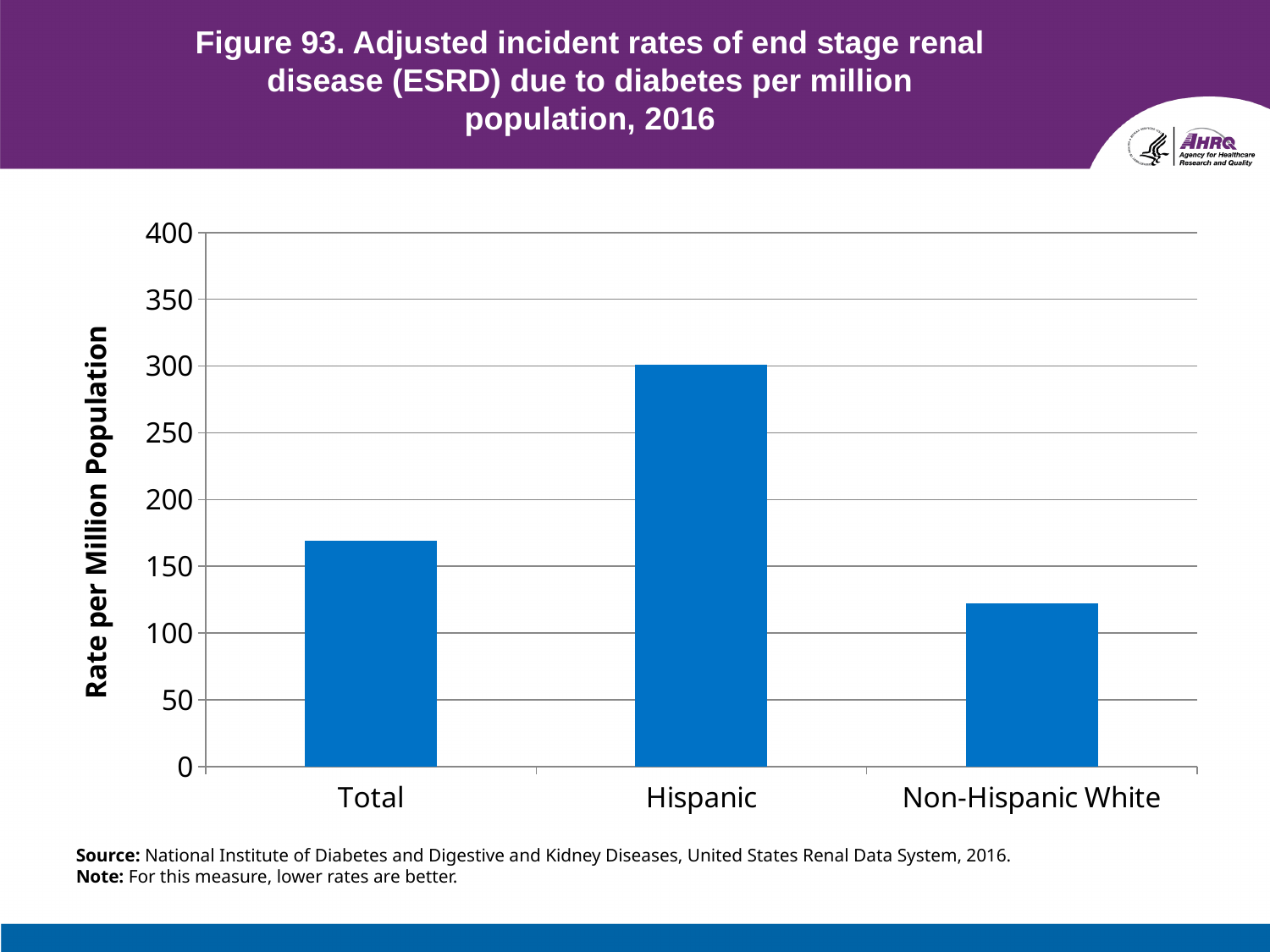
Which category has the highest adjusted incident rate of ESRD due to diabetes? Hispanic Which is larger, the rate for Hispanic or the rate for Total? Hispanic Which is larger, the rate for Total or the rate for Non-Hispanic White? Total Is the value for Non-Hispanic White greater or less than 150? less Is the value for Total greater or less than 150? greater Is the value for Non-Hispanic White greater or less than 100? greater Which category has the lowest adjusted incident rate of ESRD due to diabetes? Non-Hispanic White What kind of chart is shown on the slide? bar chart How many categories are shown on the x axis of the chart? 3 What is the label of the y axis of the chart? Rate per Million Population